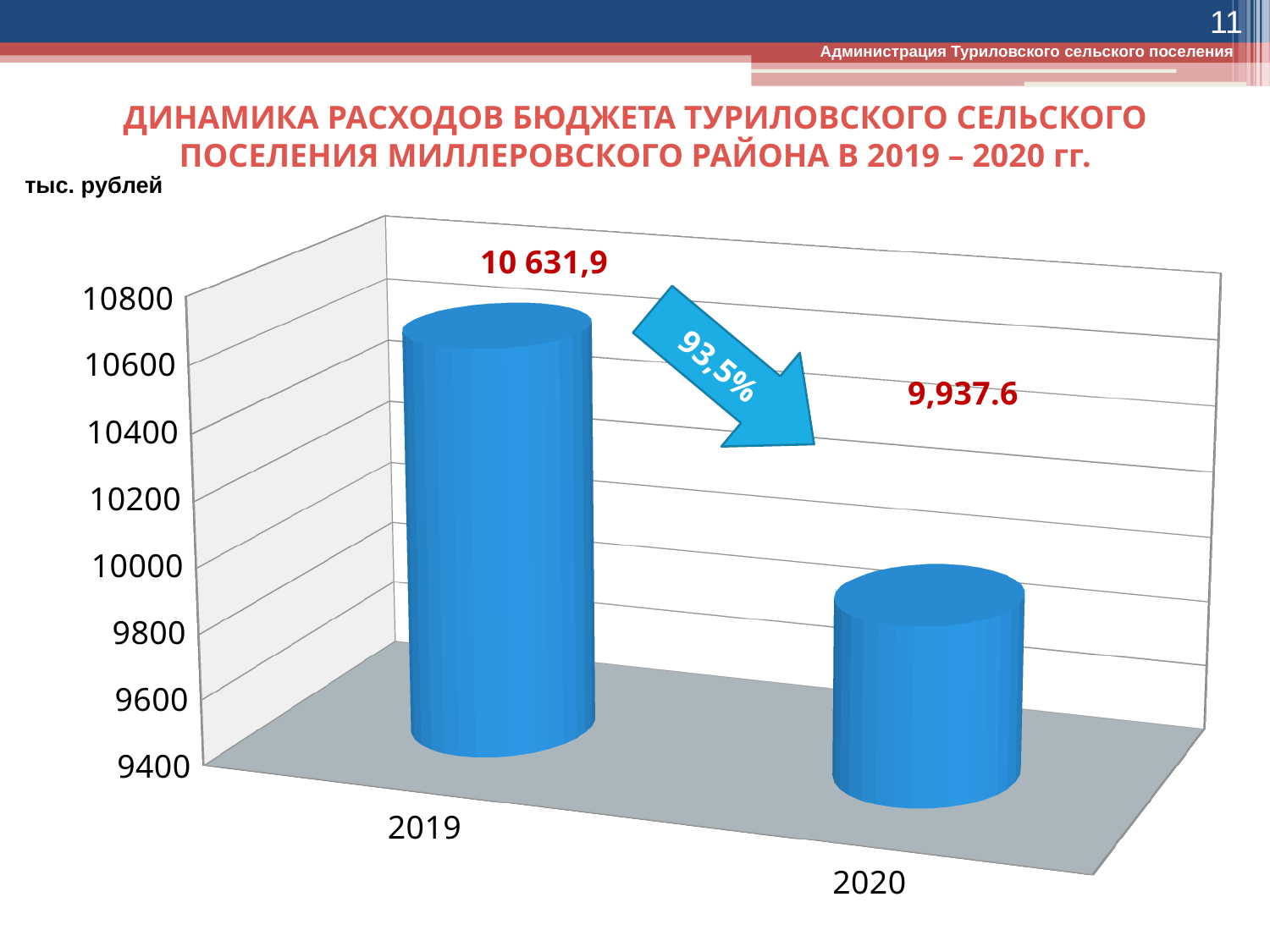
What percentage is written on the arrow between the two bars? 93,5% Do the values rise or fall from 2019 to 2020? fall Is the value for 2019 greater or less than 10400? greater Which year has the lower budget expenditure? 2020 What is the budget expenditure value shown for 2019? 10 631,9 What kind of chart is shown on the slide? bar chart How many years (categories) are plotted on the chart? 2 Is the value for 2019 larger or smaller than the value for 2020? larger By how much does the 2019 value exceed the 2020 value? 694,3 What is the budget expenditure value shown for 2020? 9,937.6 Which year has the higher budget expenditure? 2019 Is the value for 2020 greater or less than 10200? less